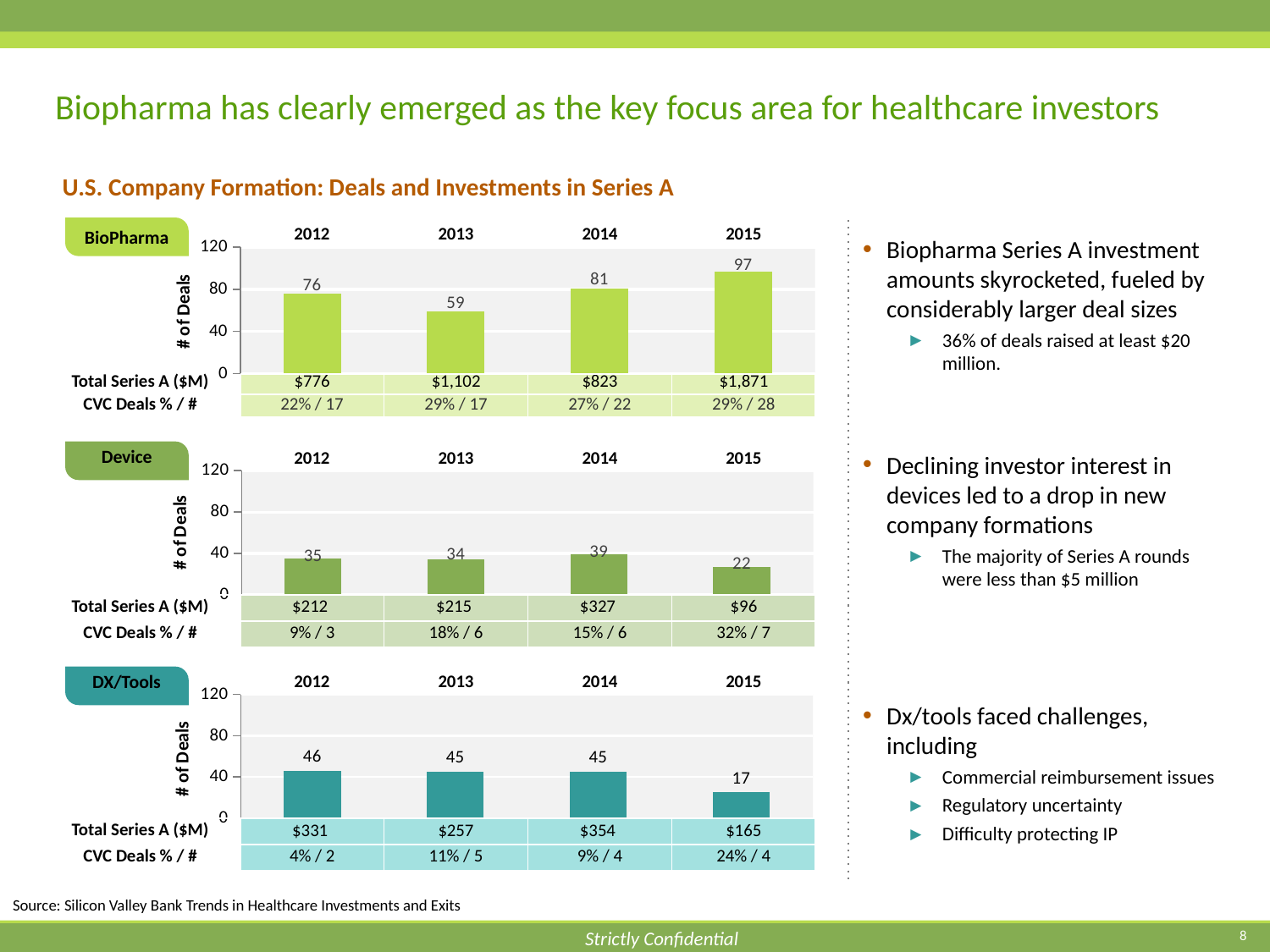
In the BioPharma chart, what is the difference in number of deals between 2015 and 2012? 21 In the BioPharma chart, which year had the lowest number of deals? 2013 In the DX/Tools chart, which year had the lowest number of deals? 2015 In the Device chart, which year had the highest number of deals? 2014 In the BioPharma chart, how many deals were there in 2015? 97 What type of chart is the Device chart? Bar chart In the DX/Tools chart, what is the difference in number of deals between 2012 and 2015? 29 In the DX/Tools chart, which is larger: the number of deals in 2012 or in 2015? 2012 In the Device chart, is the number of deals in 2015 greater or less than 40? less In the DX/Tools chart, how many deals were there in 2015? 17 In the Device chart, how many deals were there in 2014? 39 How many years are shown on the x axis of the BioPharma chart? 4